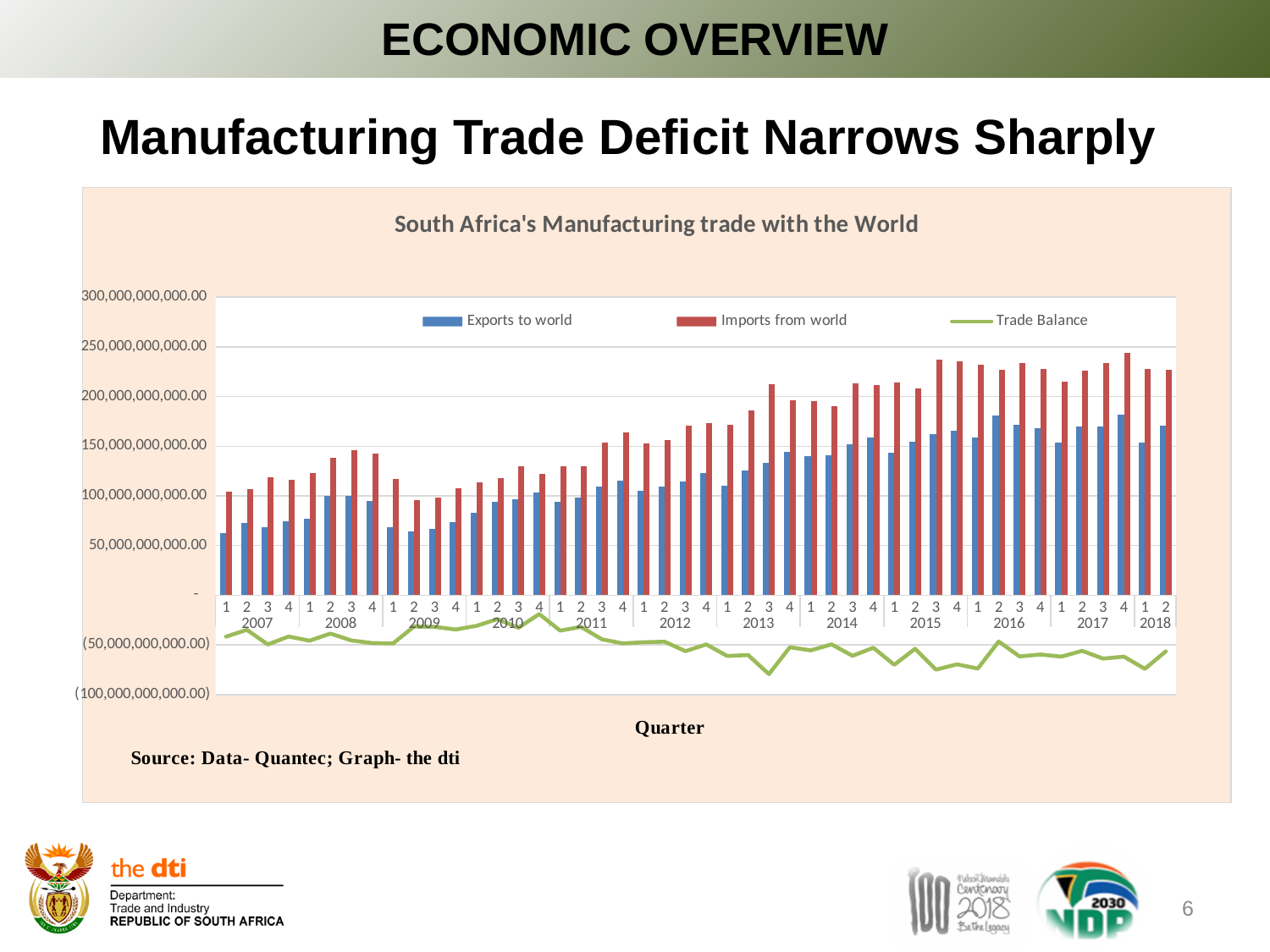
How many quarters are plotted in total? 46 In quarter 2 of 2018, which is larger: Exports to world or Imports from world? Imports from world Which is larger: Exports to world in quarter 4 of 2017 or Exports to world in quarter 1 of 2007? Quarter 4 of 2017 Is the value of Exports to world in quarter 4 of 2017 greater or less than 150,000,000,000.00? greater Overall, do Exports to world rise or fall from 2007 to 2018? Rise Is the value of Exports to world in quarter 1 of 2007 greater or less than 100,000,000,000.00? less How many years are shown on the x axis? 12 Is the value of Imports from world in quarter 4 of 2017 greater or less than 200,000,000,000.00? greater Which series is plotted as a line rather than bars? Trade Balance What is the title of the chart? South Africa's Manufacturing trade with the World What kind of chart is this? Combined bar and line chart How many series does the chart legend list? 3